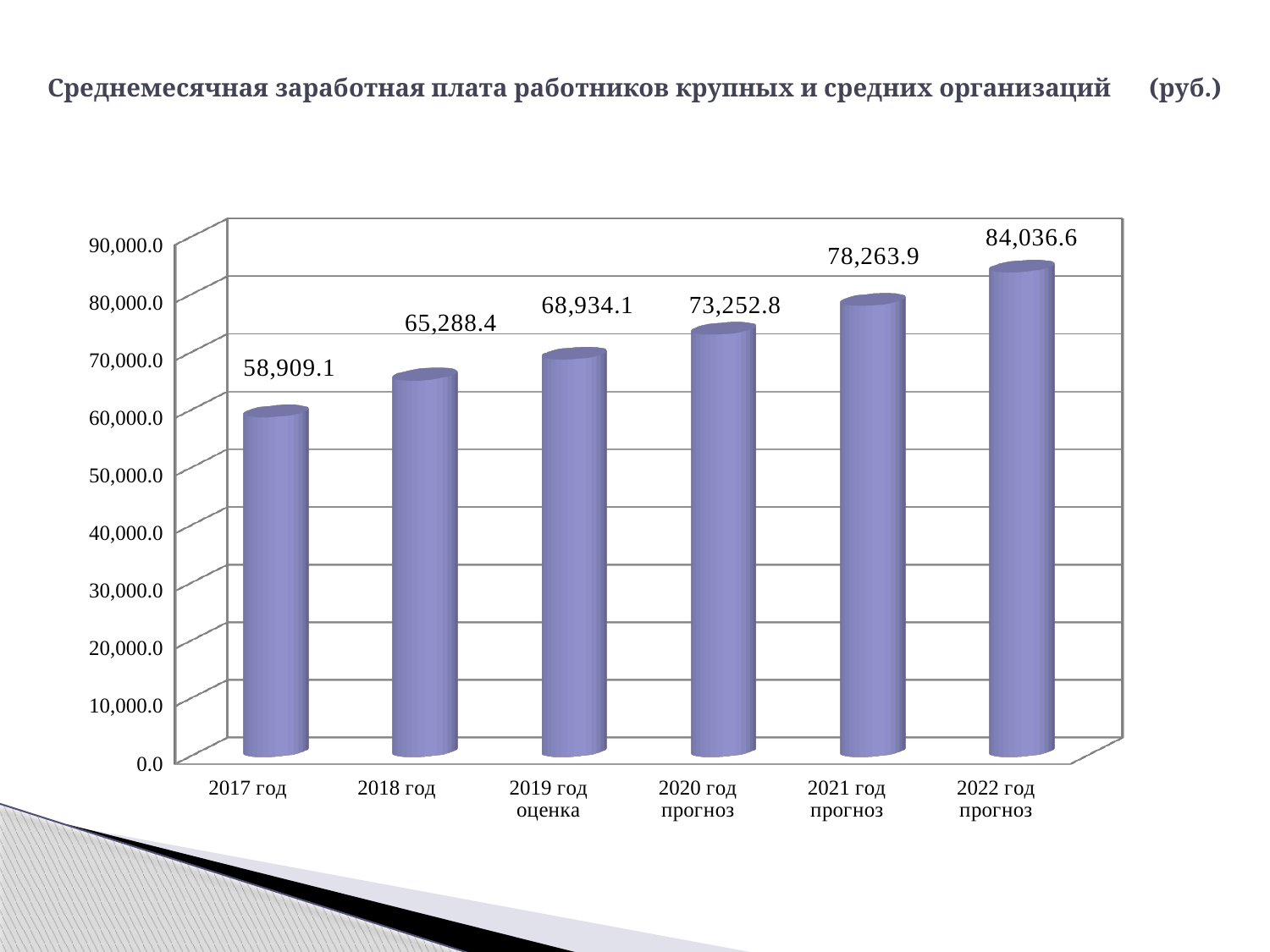
Which category has the lowest value? 2017 год Which category has the highest value? 2022 год прогноз What kind of chart is shown on the slide? bar chart What is the value for 2019 год оценка? 68,934.1 Which is larger, the value for 2018 год or the value for 2019 год оценка? 2019 год оценка What is the value for 2020 год прогноз? 73,252.8 Is the value for 2021 год прогноз greater or less than 70,000.0? greater What is the difference between the values for 2022 год прогноз and 2017 год? 25,127.5 How many categories are shown on the x axis? 6 What is the value for 2017 год? 58,909.1 Do the values rise or fall from 2017 год to 2022 год прогноз? rise What is the difference between the values for 2021 год прогноз and 2020 год прогноз? 5,011.1